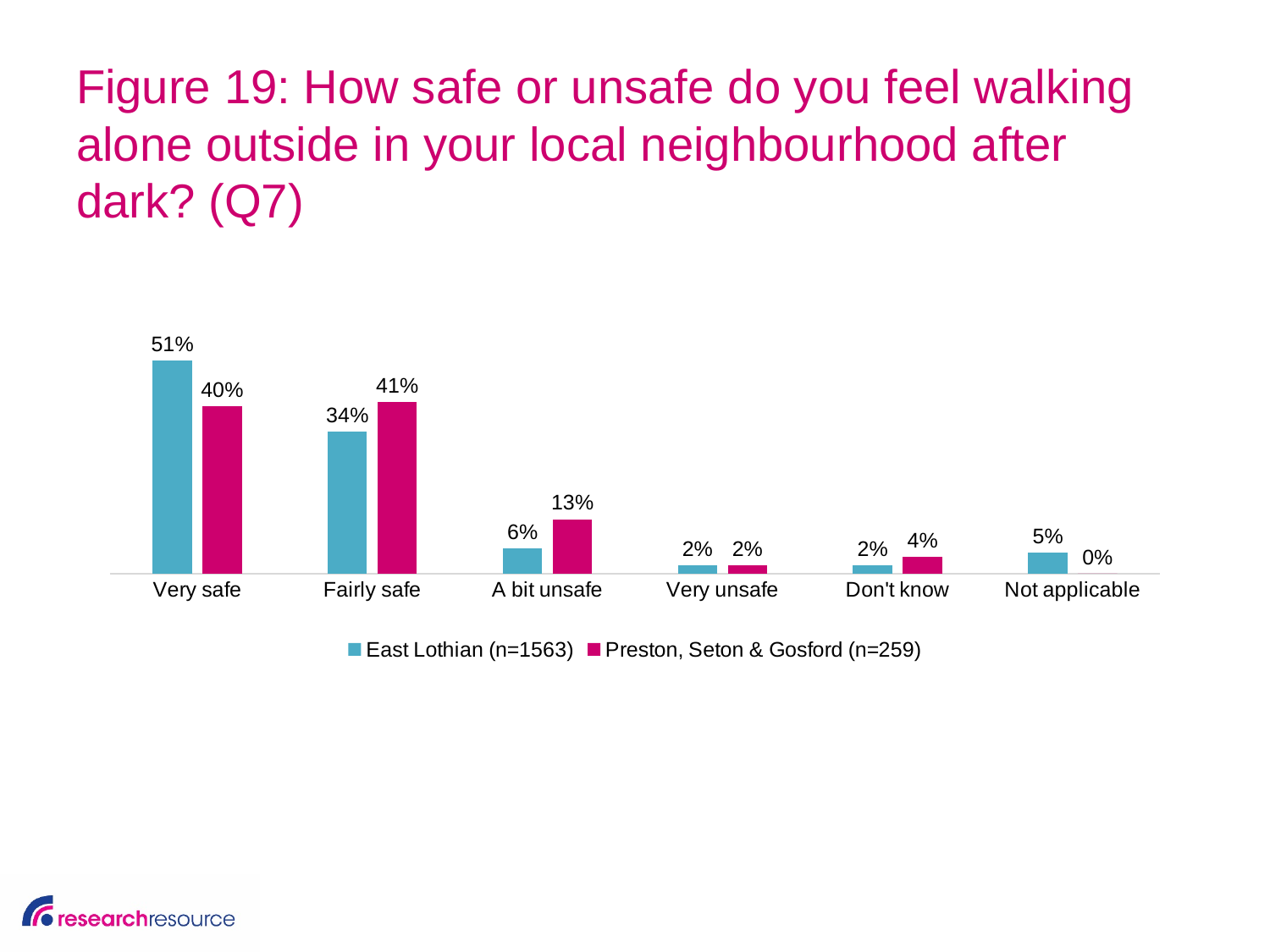
How many series does the legend list? 2 For 'Fairly safe', which series has the larger value: East Lothian or Preston, Seton & Gosford? Preston, Seton & Gosford What kind of chart is shown on the slide? Bar chart Which category has the highest value for East Lothian? Very safe What is the difference between the East Lothian and Preston, Seton & Gosford values for 'Very safe'? 11 percentage points What is the sample size (n) for the East Lothian series shown in the legend? 1563 What percentage of Preston, Seton & Gosford respondents said they feel fairly safe? 41% What is the value for Preston, Seton & Gosford in the 'A bit unsafe' category? 13% What percentage of East Lothian respondents said they feel very safe? 51% Which category has the lowest value for Preston, Seton & Gosford? Not applicable How many response categories are shown on the x axis? 6 What is the difference between the Preston, Seton & Gosford and East Lothian values for 'A bit unsafe'? 7 percentage points